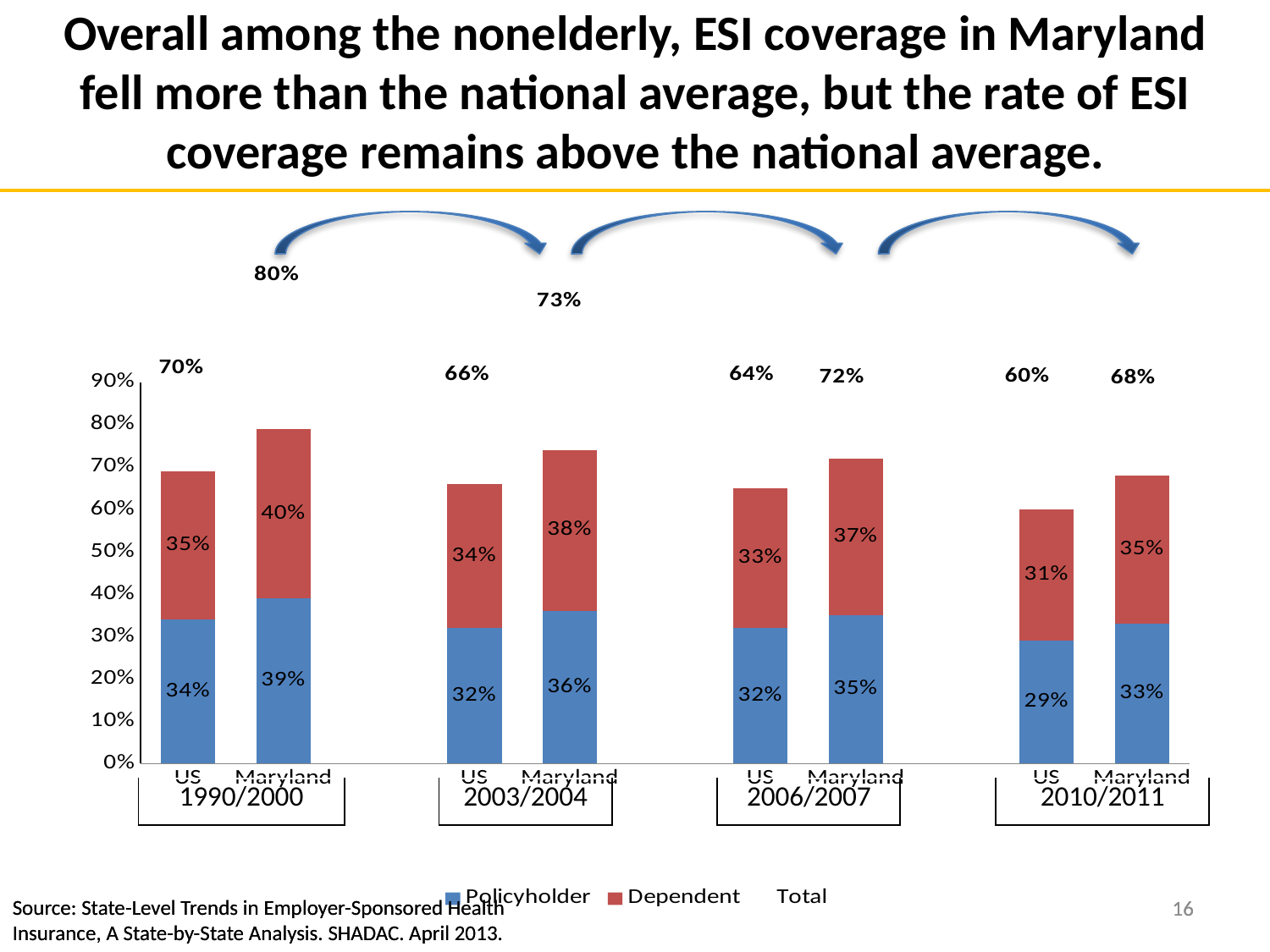
What total ESI coverage is labeled for Maryland in 2010/2011? 68% What is the Dependent value for US in 2006/2007? 33% Is the total bar for US in 2010/2011 greater or less than 70%? less What kind of chart is shown on the slide? Stacked bar chart How many series does the legend list? 3 Do the US total values rise or fall from 1990/2000 to 2010/2011? fall What is the difference between the Policyholder values for Maryland and US in 1990/2000? 5 percentage points What total ESI coverage is labeled for US in 2003/2004? 66% Which bar has the highest Policyholder value? Maryland 1990/2000 Which bar has the lowest Policyholder value? US 2010/2011 What is the Policyholder value for Maryland in 1990/2000? 39% Which is larger: the Dependent value for US in 2003/2004 or the Dependent value for Maryland in 2006/2007? Maryland in 2006/2007